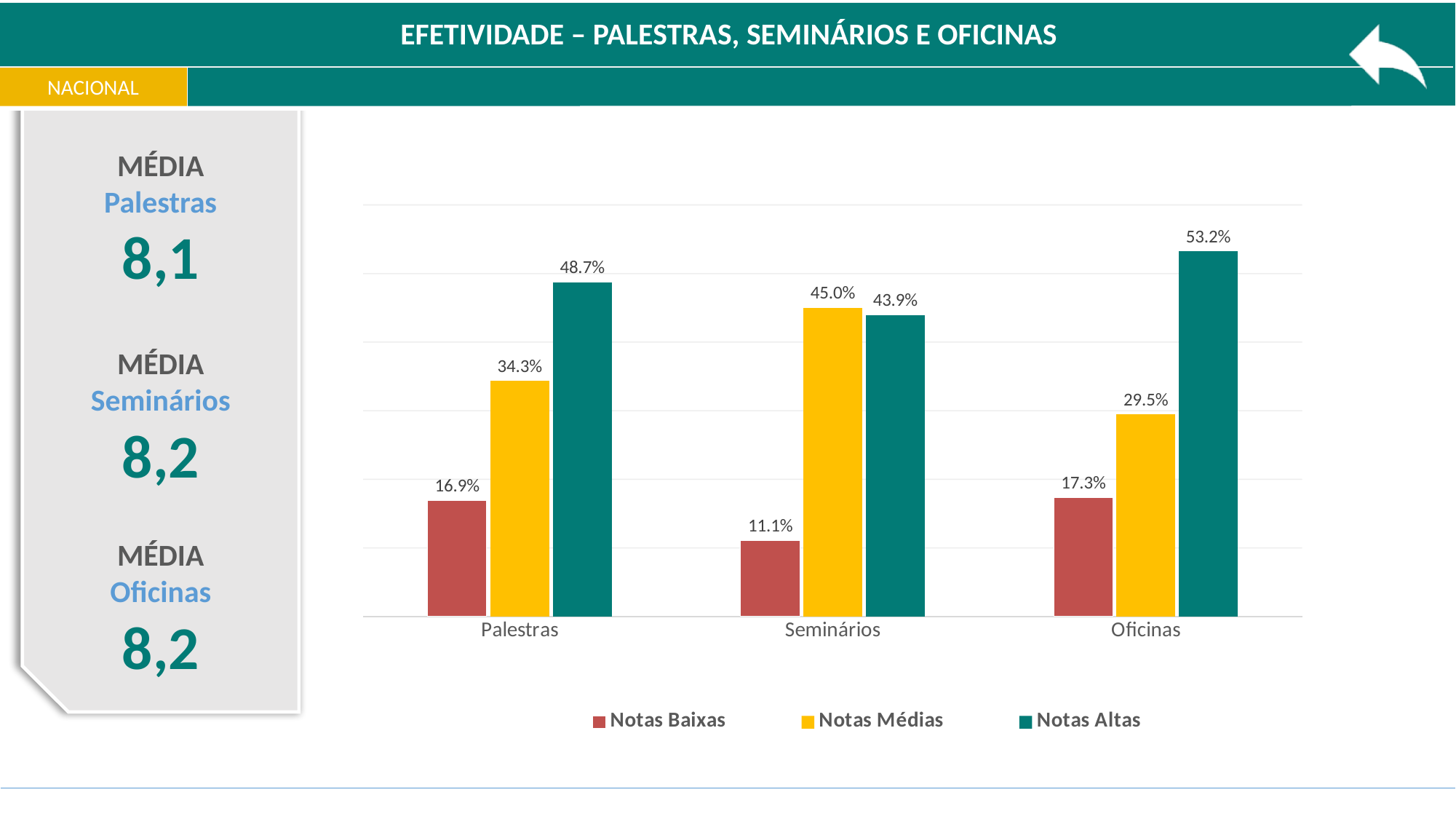
What kind of chart is shown on the slide? Bar chart Which is larger for Seminários: Notas Médias or Notas Altas? Notas Médias Which category has the highest Notas Altas value? Oficinas Which category has the lowest Notas Baixas value? Seminários How many categories are shown on the x axis? 3 What is the difference between Notas Baixas for Oficinas and Notas Baixas for Palestras? 0.4% Which colour represents Notas Altas in the legend? Teal (green) How many series does the legend list? 3 What is the difference between Notas Altas and Notas Médias for Palestras? 14.4% What is the value of Notas Médias for Palestras? 34.3% What is the value of Notas Baixas for Seminários? 11.1% What is the value of Notas Altas for Oficinas? 53.2%